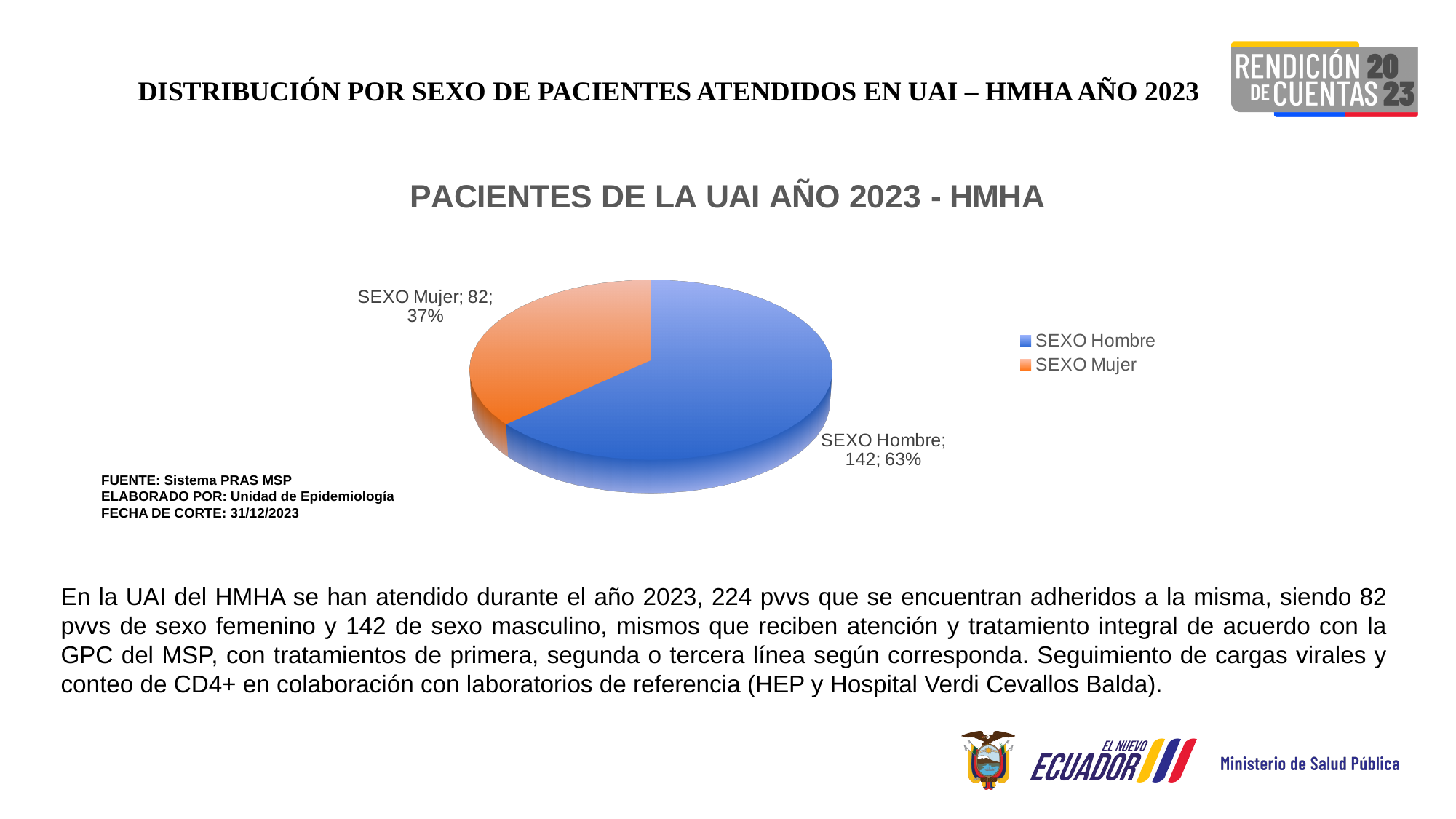
Which category has the largest slice of the pie? SEXO Hombre What percentage share of the pie does SEXO Hombre represent? 63% How many categories does the pie chart have? 2 How many patients are in the SEXO Hombre slice? 142 What is the title of the chart? PACIENTES DE LA UAI AÑO 2023 - HMHA What is the total number of patients represented in the pie chart? 224 How many patients are in the SEXO Mujer slice? 82 Which is larger, the SEXO Hombre slice or the SEXO Mujer slice? SEXO Hombre What percentage share of the pie does SEXO Mujer represent? 37% What type of chart is shown on the slide? Pie chart Which category has the smallest slice of the pie? SEXO Mujer What is the difference between the number of SEXO Hombre and SEXO Mujer patients? 60